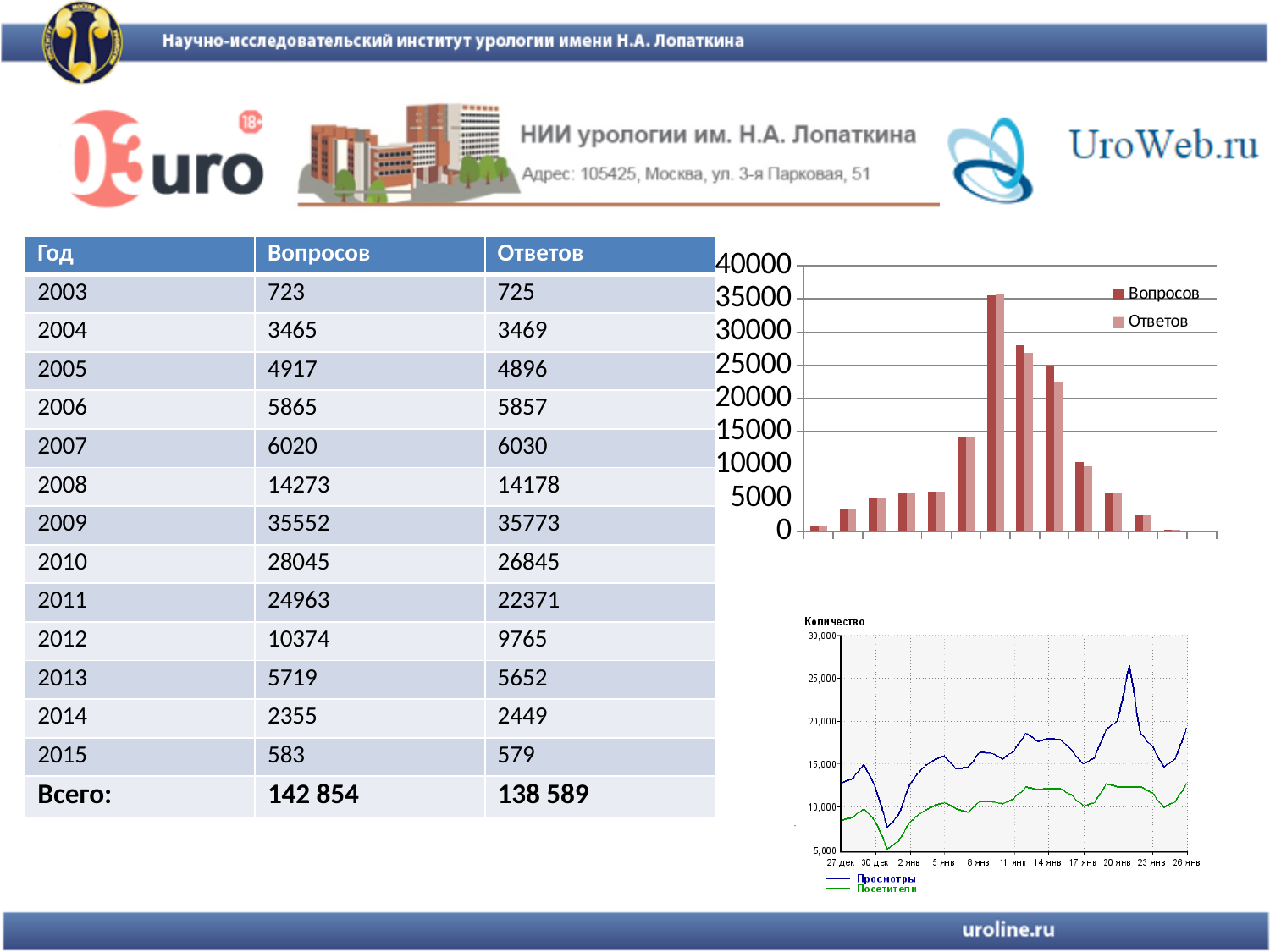
What kind of chart is the lower chart on the right of the slide? line chart In the upper bar chart, is the value of the last (rightmost) Вопросов bar greater or less than 5000? less In the lower line chart, which series is plotted in blue? Просмотры How many series does the legend of the lower line chart list? 2 In the upper bar chart, is the value of the tallest Вопросов bar greater or less than 30000? greater How many series does the legend of the upper bar chart list? 2 What are the two series named in the legend of the upper bar chart? Вопросов and Ответов What kind of chart is the upper chart on the right of the slide? bar chart In the lower line chart, is the peak value of the Просмотры line greater or less than 25,000? greater In the lower line chart, which series has the higher value at 26 янв, Просмотры or Посетители? Просмотры How many groups of bars are plotted in the upper bar chart? 13